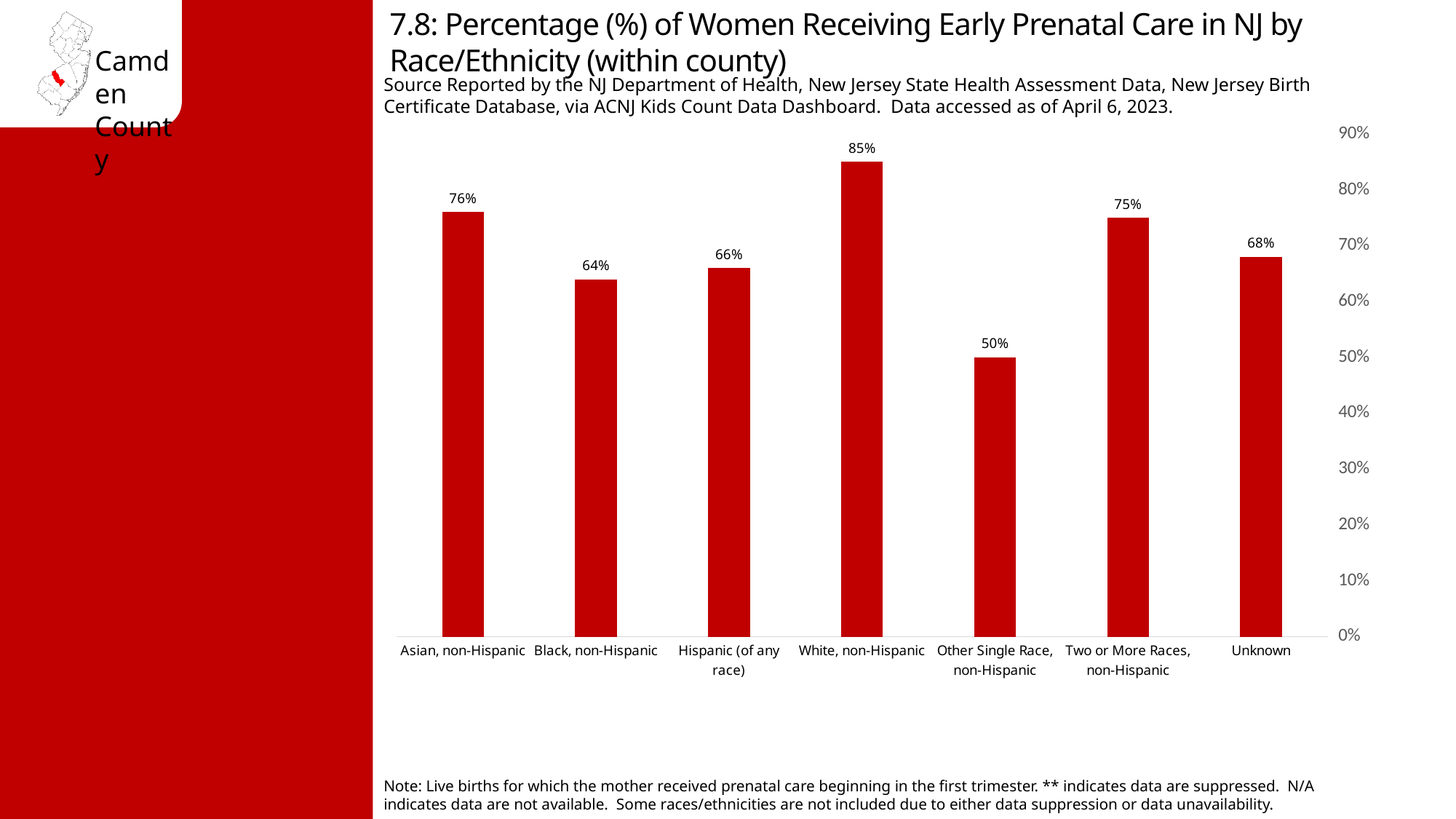
What type of chart is shown on the slide? Bar chart Which category has the lowest percentage? Other Single Race, non-Hispanic How many race/ethnicity categories are shown on the chart? 7 What is the difference in percentage points between White, non-Hispanic and Other Single Race, non-Hispanic? 35 What percentage is shown for the Unknown category? 68% What is the maximum value shown on the vertical axis? 90% Which is larger, the value for Asian, non-Hispanic or the value for Two or More Races, non-Hispanic? Asian, non-Hispanic Which race/ethnicity category has the highest percentage of women receiving early prenatal care? White, non-Hispanic What is the difference between Asian, non-Hispanic and Hispanic (of any race)? 10 What percentage of White, non-Hispanic women received early prenatal care? 85% Is the value for Hispanic (of any race) greater or less than 60%? greater What is the value shown for Black, non-Hispanic? 64%